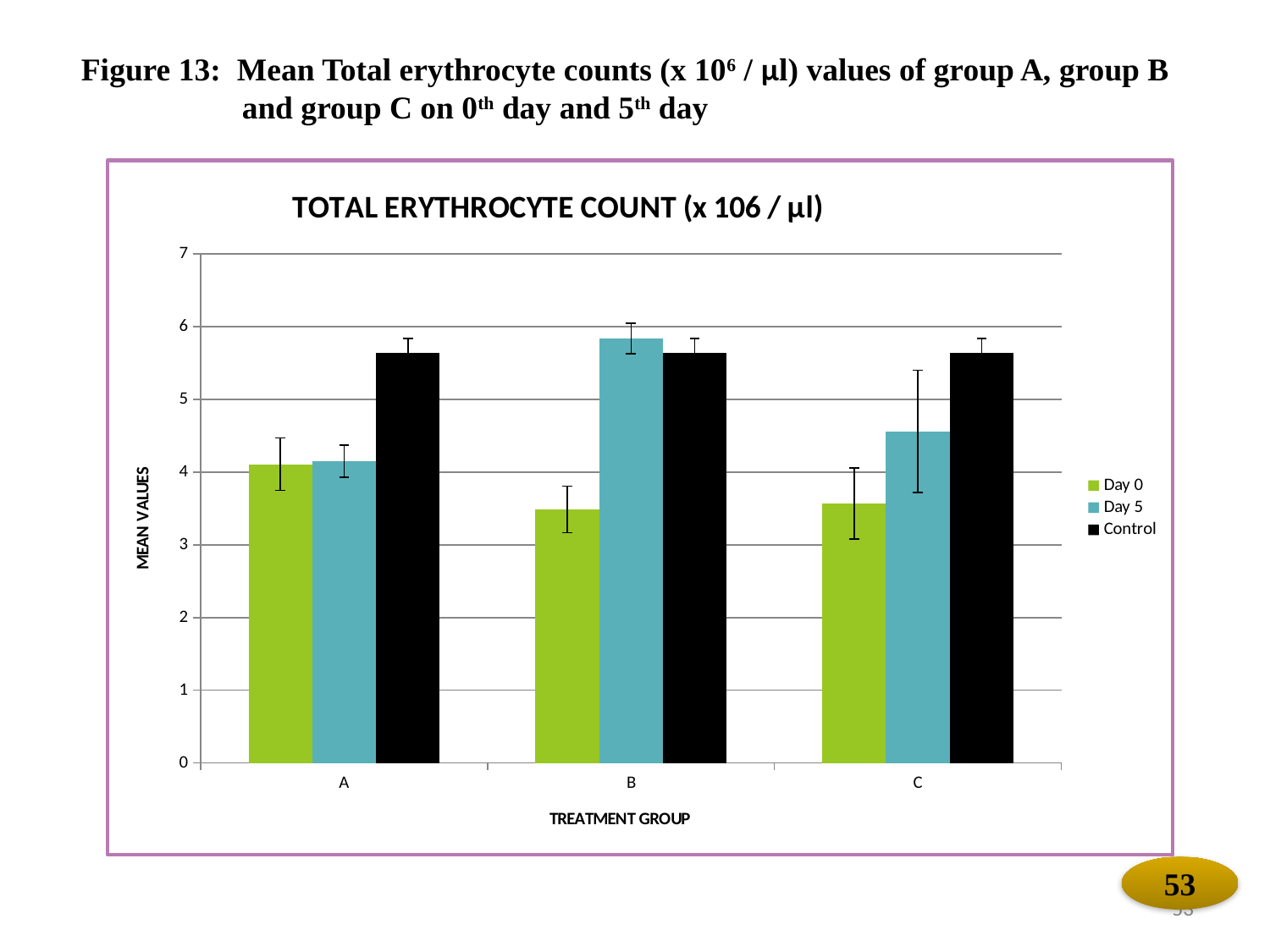
How many series does the legend list? 3 For treatment group B, which is larger: the Day 0 value or the Day 5 value? Day 5 Which treatment group has the lowest Day 5 value? A Is the Day 5 value for treatment group B greater or less than 5? greater Is the Day 5 value for treatment group C greater or less than 5? less Which is larger: the Day 0 value for group A or the Day 0 value for group B? Group A Is the Day 0 value for treatment group B greater or less than 4? less What kind of chart is shown on the slide? Bar chart Which treatment group has the highest Day 5 value? B What are the three entries listed in the chart legend? Day 0, Day 5, Control How many treatment groups are shown on the x axis? 3